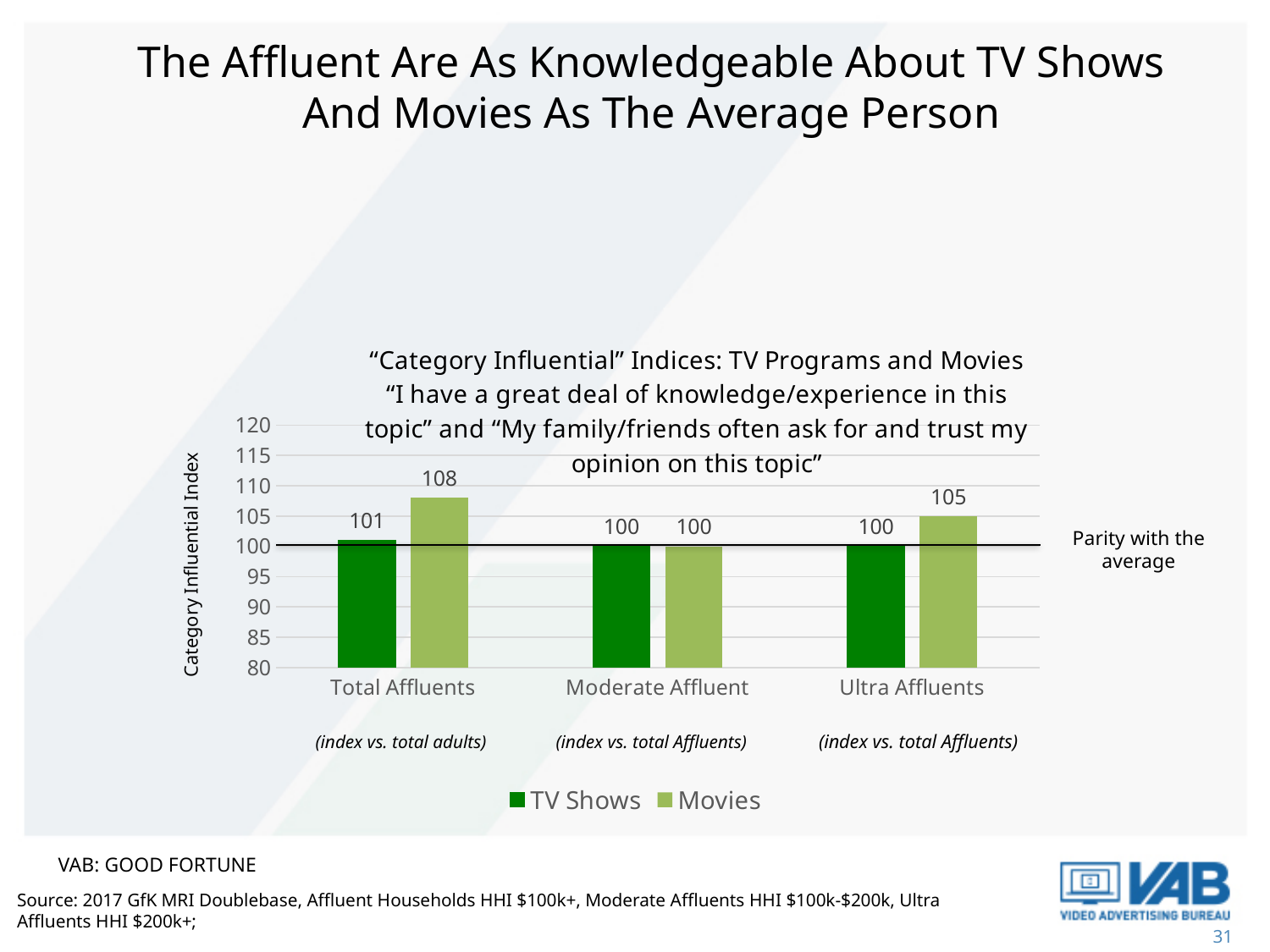
What is the Movies index for Total Affluents? 108 Which category has the highest Movies index? Total Affluents What is the TV Shows index for Total Affluents? 101 What is the difference between the Movies index and the TV Shows index for Total Affluents? 7 For Ultra Affluents, which is larger: the TV Shows index or the Movies index? Movies What kind of chart is shown on the slide? Bar chart What is the difference between the Movies index for Total Affluents and the Movies index for Ultra Affluents? 3 What is the TV Shows index for Ultra Affluents? 100 How many series does the legend list? 2 What is the label of the y axis? Category Influential Index How many categories are shown on the x axis? 3 What is the Movies index for Moderate Affluent? 100